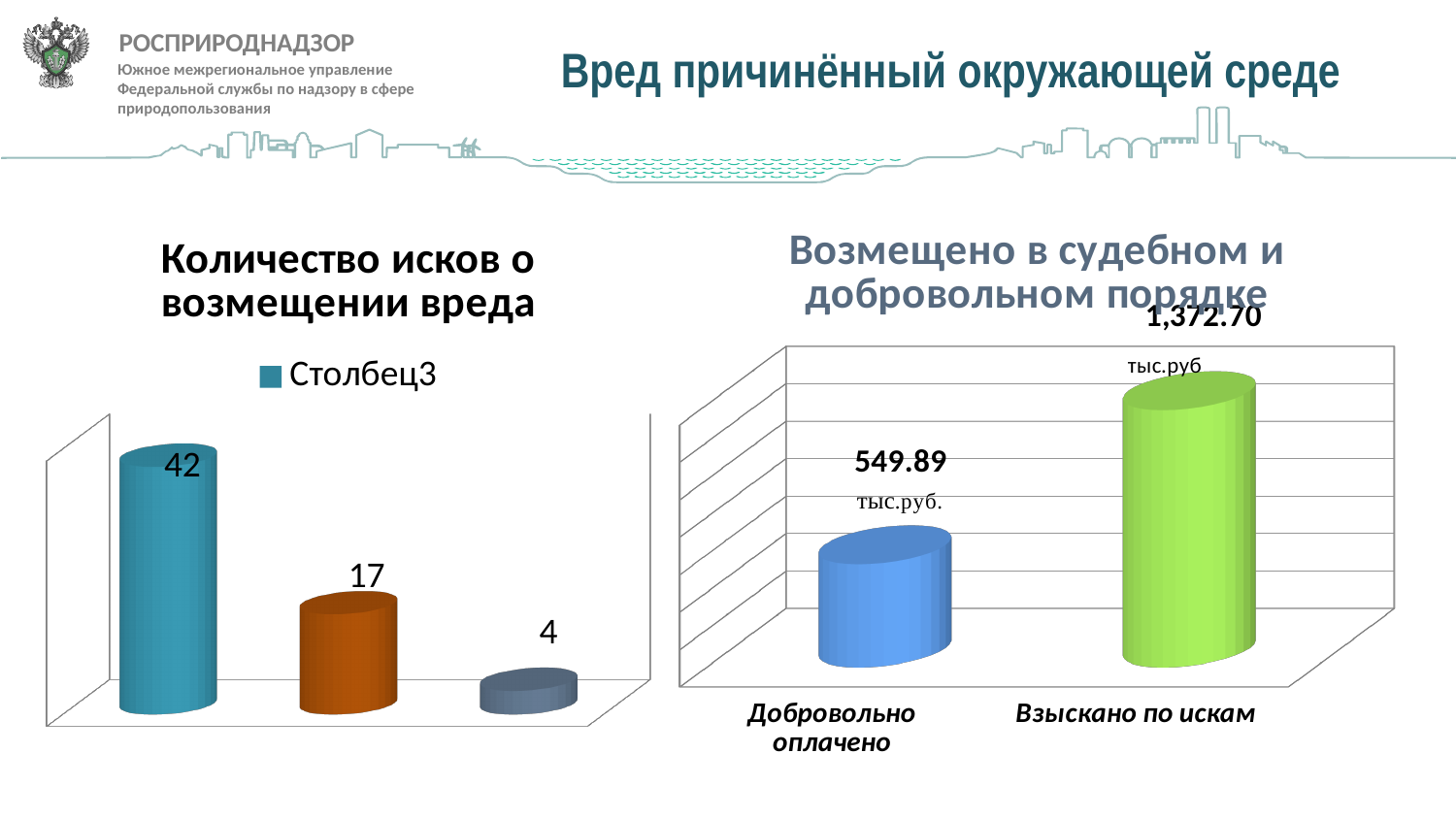
In the chart titled "Возмещено в судебном и добровольном порядке", what is the value for "Взыскано по искам"? 1,372.70 тыс.руб In the chart titled "Количество исков о возмещении вреда", what is the highest value shown? 42 What kind of chart is the one titled "Возмещено в судебном и добровольном порядке"? Bar chart In the chart titled "Возмещено в судебном и добровольном порядке", what is the difference between "Взыскано по искам" and "Добровольно оплачено"? 822.81 тыс.руб. In the chart titled "Количество исков о возмещении вреда", what is the legend entry? Столбец3 In the chart titled "Возмещено в судебном и добровольном порядке", what is the value for "Добровольно оплачено"? 549.89 тыс.руб. In the chart titled "Возмещено в судебном и добровольном порядке", how many categories are shown? 2 In the chart titled "Возмещено в судебном и добровольном порядке", which category has the lowest value? Добровольно оплачено In the chart titled "Количество исков о возмещении вреда", how many bars are shown? 3 In the chart titled "Количество исков о возмещении вреда", what is the lowest value shown? 4 In the chart titled "Количество исков о возмещении вреда", what is the difference between the highest and lowest values? 38 In the chart titled "Возмещено в судебном и добровольном порядке", which category has the higher value? Взыскано по искам